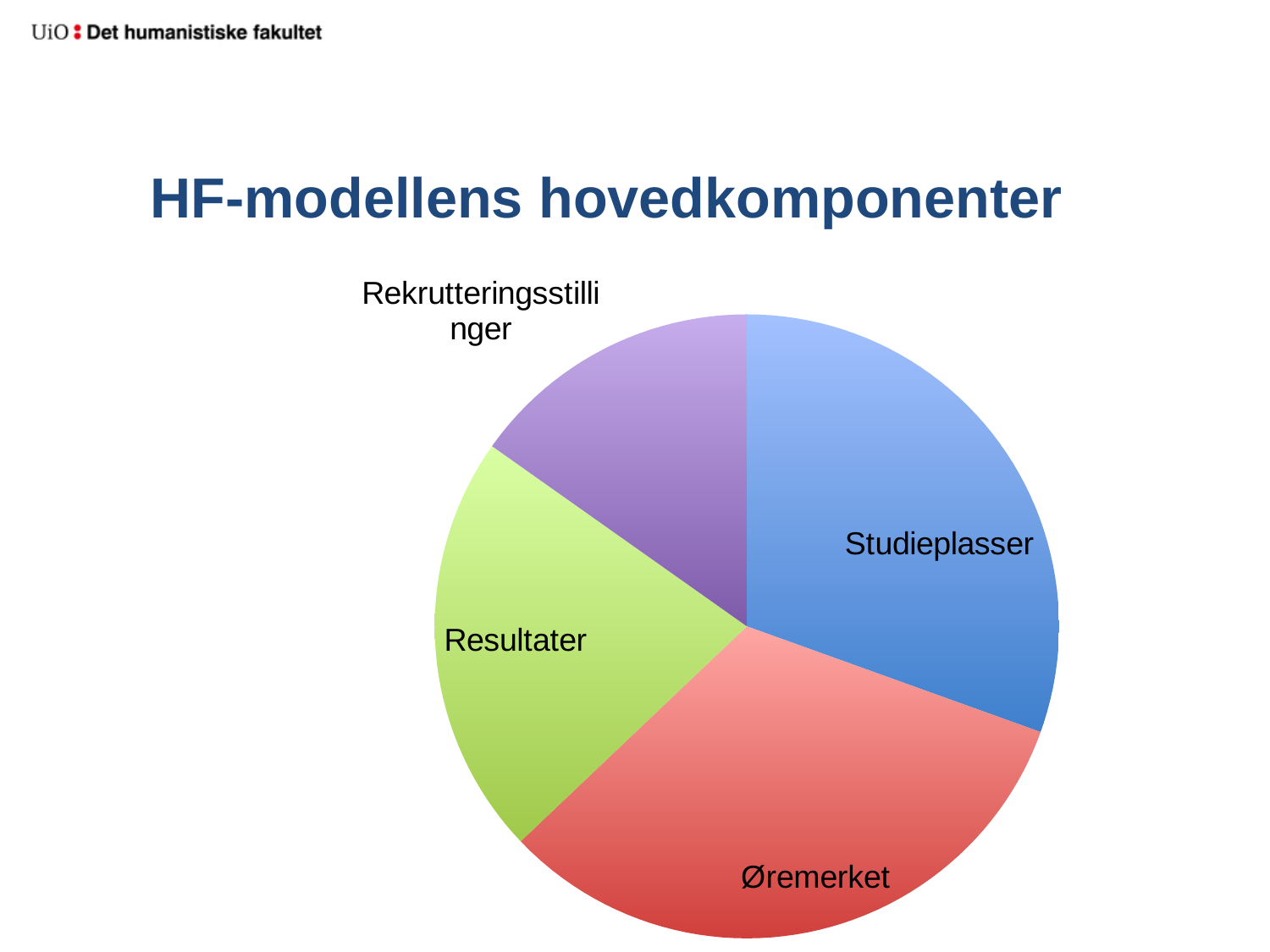
How many slices does the pie chart have? 4 What kind of chart is shown on the slide? Pie chart Which slice is larger, Resultater or Rekrutteringsstillinger? Resultater Which slice is larger, Studieplasser or Rekrutteringsstillinger? Studieplasser Which slice of the pie chart is the smallest? Rekrutteringsstillinger What is the title of the chart on the slide? HF-modellens hovedkomponenter What colour is the Øremerket slice of the pie chart? Red Which slice is larger, Øremerket or Resultater? Øremerket